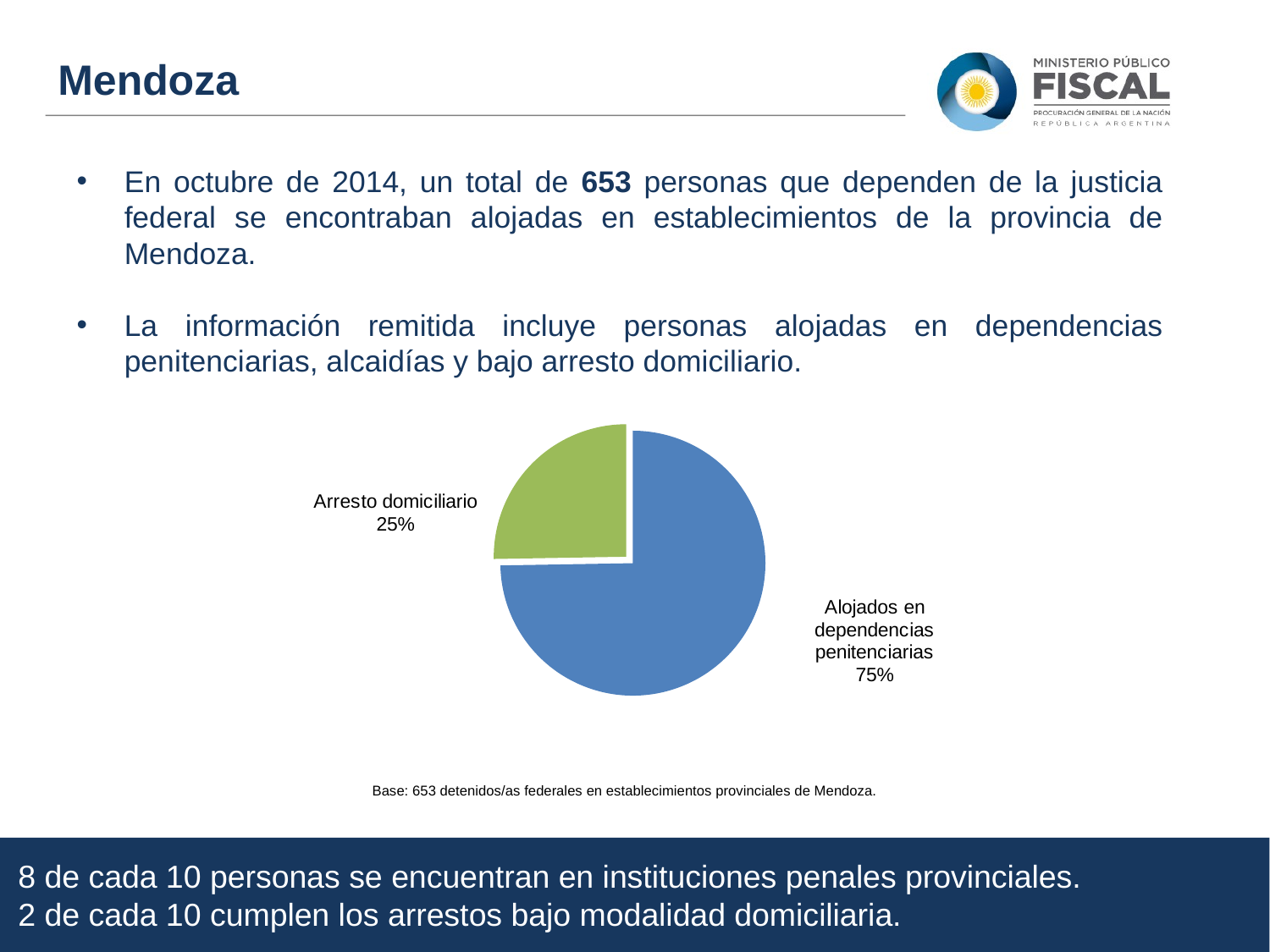
Which is larger: the share for "Arresto domiciliario" or the share for "Alojados en dependencias penitenciarias"? Alojados en dependencias penitenciarias Which slice of the pie is the smallest? Arresto domiciliario What colour is the "Alojados en dependencias penitenciarias" slice? blue What kind of chart is shown on the slide? pie chart What colour is the "Arresto domiciliario" slice? green What share of the pie does "Arresto domiciliario" represent? 25% How many slices does the pie chart have? 2 What share of the pie does "Alojados en dependencias penitenciarias" represent? 75% What is the difference in percentage points between the "Alojados en dependencias penitenciarias" slice and the "Arresto domiciliario" slice? 50 percentage points Which slice of the pie is the largest? Alojados en dependencias penitenciarias What is the base (total number of cases) stated below the pie chart? 653